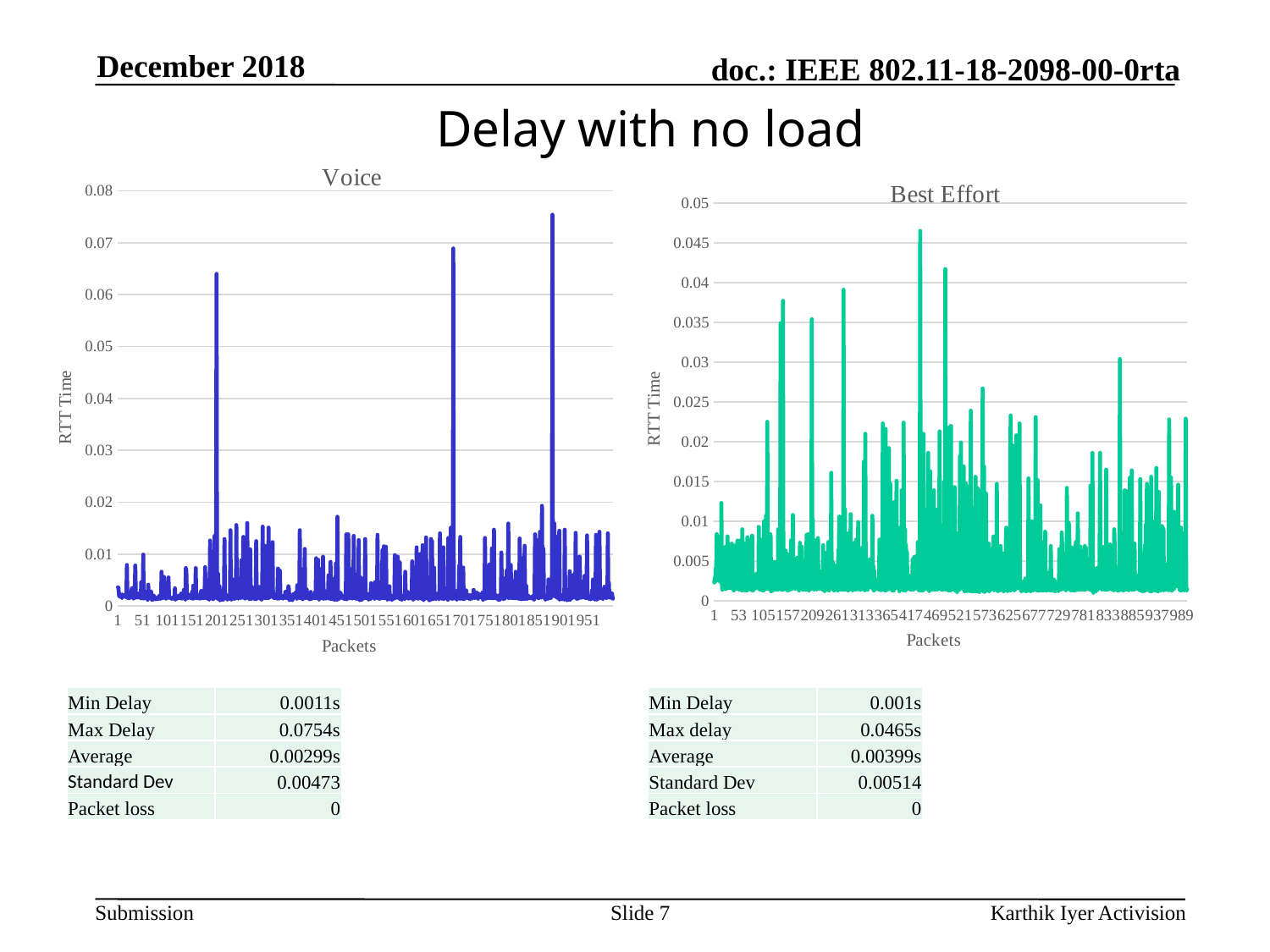
What is the maximum value shown on the y axis of the Voice chart? 0.08 How many charts are shown on the slide? 2 What kind of chart is the Voice chart? line chart In the Voice chart, is the value at packet 1 greater or less than 0.02? less In the Best Effort chart, is the value at packet 989 greater or less than 0.03? less What is the maximum value shown on the y axis of the Best Effort chart? 0.05 What kind of chart is the Best Effort chart? line chart In the Voice chart, is the peak near packet 201 greater or less than 0.06? greater Which chart reaches a higher maximum RTT Time, Voice or Best Effort? Voice